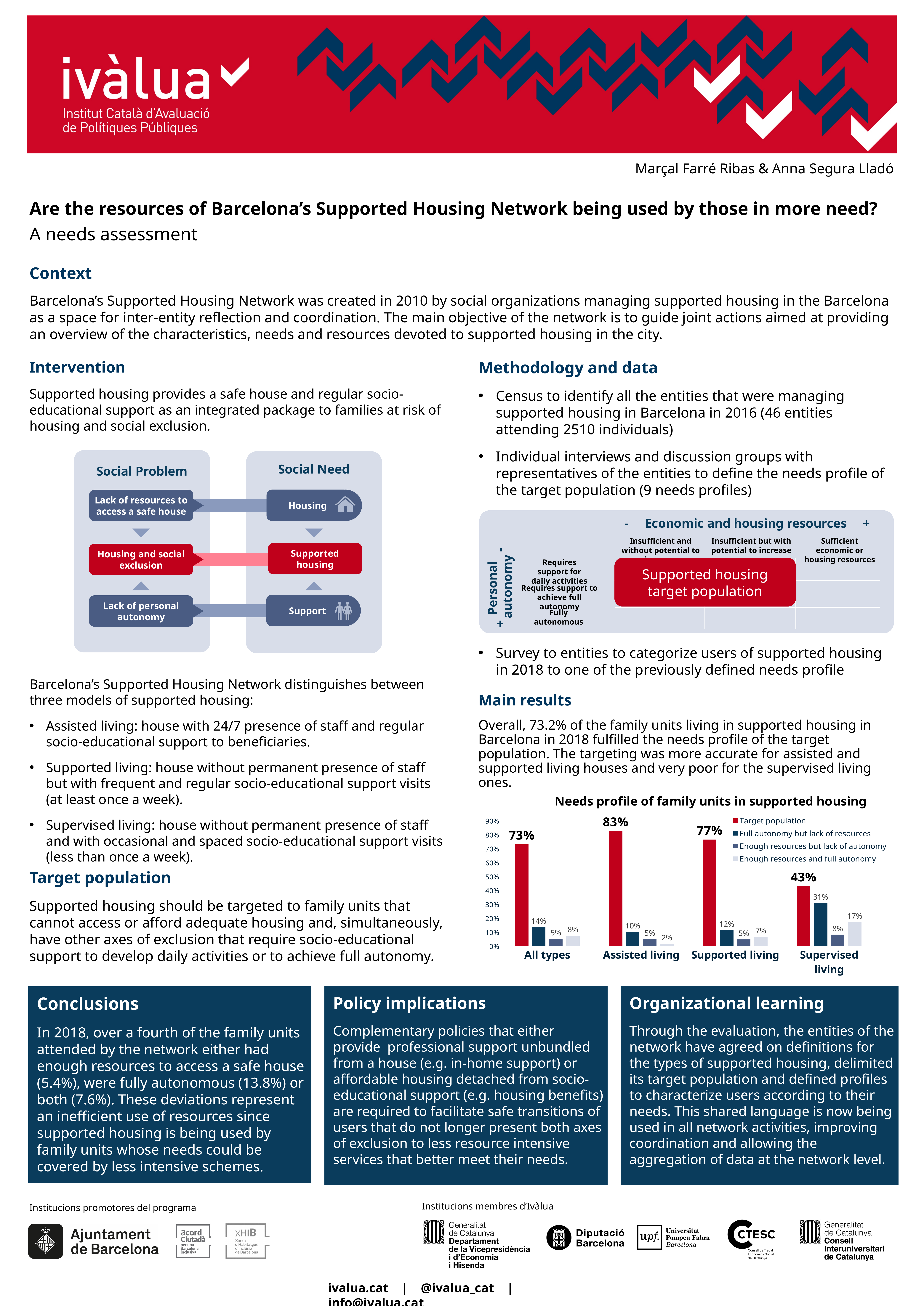
In the chart 'Needs profile of family units in supported housing', what is the 'Enough resources and full autonomy' value for All types? 8% In the chart 'Needs profile of family units in supported housing', is the Target population value for Supported living greater or less than 70%? greater How many categories are shown on the x axis of the chart 'Needs profile of family units in supported housing'? 4 In the chart 'Needs profile of family units in supported housing', which is larger: the 'Enough resources and full autonomy' value for Supervised living or for Supported living? Supervised living What kind of chart is 'Needs profile of family units in supported housing'? Bar chart Which category has the highest Target population value in the chart 'Needs profile of family units in supported housing'? Assisted living How many series does the legend of the chart 'Needs profile of family units in supported housing' list? 4 What is the Target population value for Assisted living in the chart 'Needs profile of family units in supported housing'? 83% In the chart 'Needs profile of family units in supported housing', what is the value for 'Full autonomy but lack of resources' in Supervised living? 31% In the chart 'Needs profile of family units in supported housing', which colour represents the Target population series? Red In the chart 'Needs profile of family units in supported housing', what is the difference between the Target population values for Assisted living and Supervised living? 40 percentage points Which category has the lowest Target population value in the chart 'Needs profile of family units in supported housing'? Supervised living